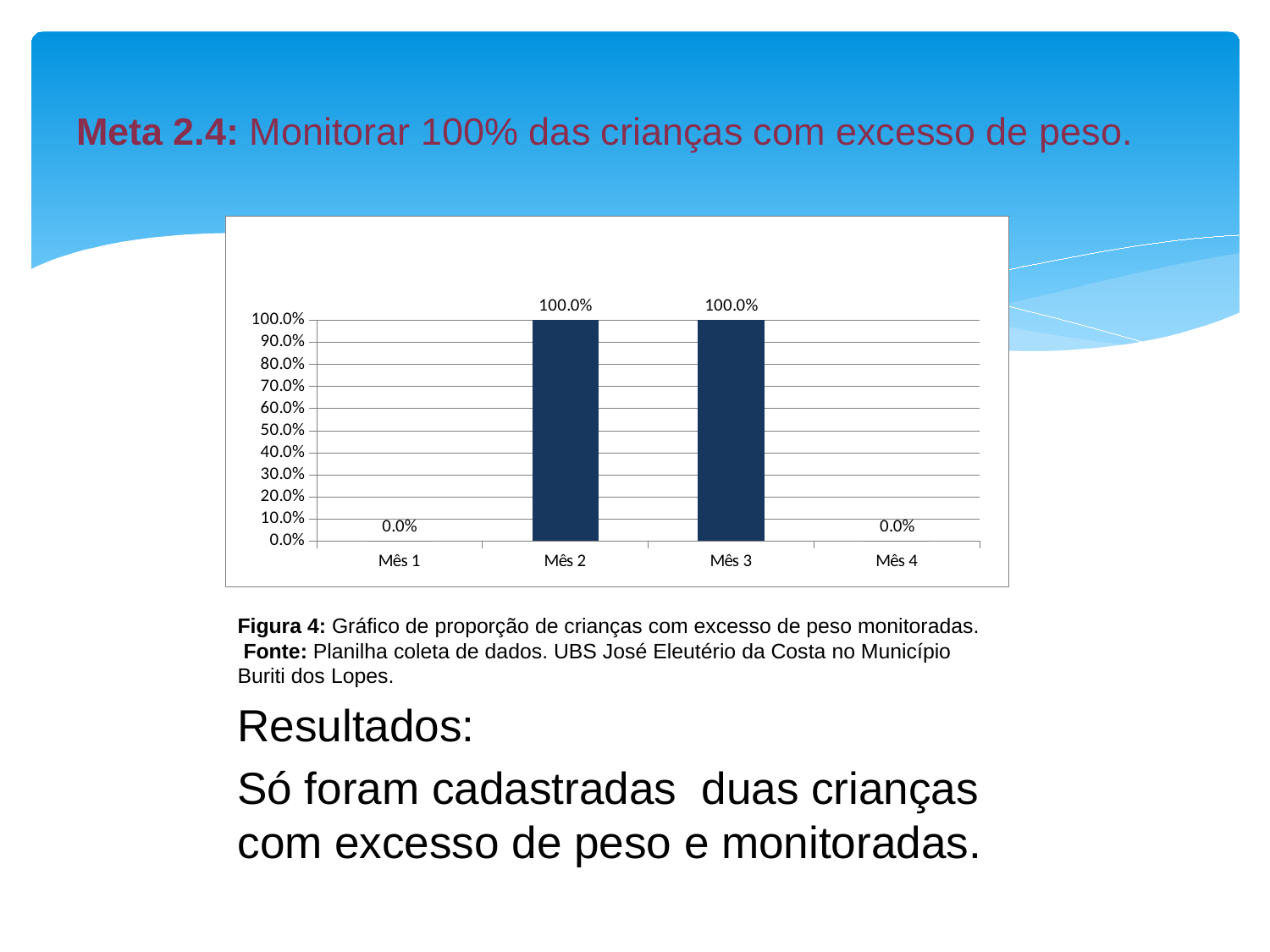
What is the difference between the values for Mês 3 and Mês 1? 100.0% How many categories are shown on the x axis? 4 Is the value for Mês 2 greater or less than 50.0%? greater What kind of chart is shown on the slide? Bar chart What is the value for Mês 2? 100.0% What colour are the bars in the chart? Dark blue What is the value for Mês 3? 100.0% What is the value for Mês 1? 0.0% What is the highest value shown on the y axis? 100.0% Which is larger, the value for Mês 2 or the value for Mês 4? Mês 2 What is the value for Mês 4? 0.0% Which months have a value of 0.0%? Mês 1 and Mês 4